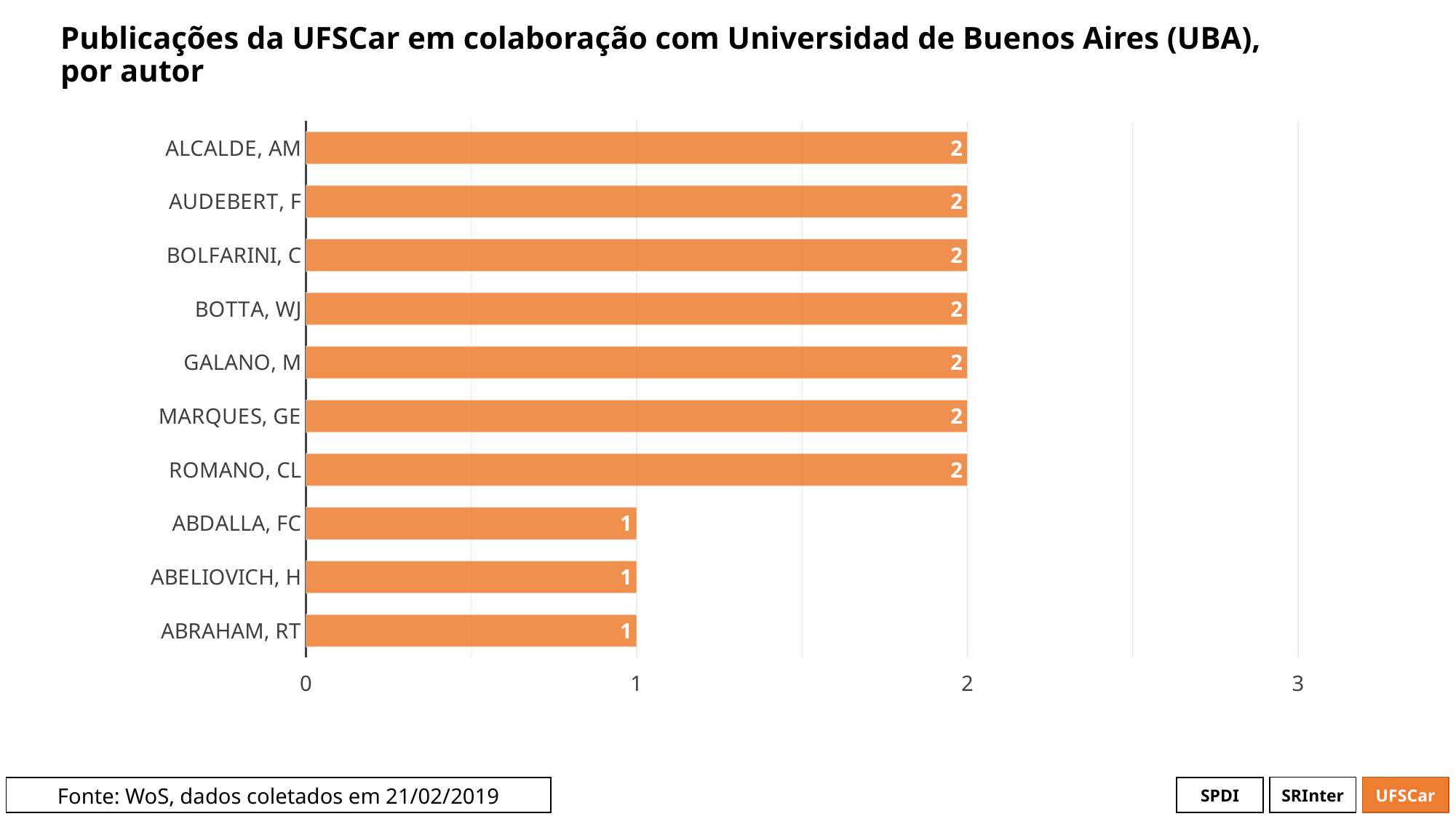
What is the data source stated at the bottom of the slide? WoS, dados coletados em 21/02/2019 How many authors have a value of 2? 7 What is the difference between the values for GALANO, M and ABELIOVICH, H? 1 What kind of chart is shown on the slide? bar chart Which is larger, the value for BOTTA, WJ or the value for ABDALLA, FC? BOTTA, WJ What is the value for ABDALLA, FC? 1 How many authors are listed in the chart? 10 What is the value for ABRAHAM, RT? 1 What is the title of the chart? Publicações da UFSCar em colaboração com Universidad de Buenos Aires (UBA), por autor What is the value for ROMANO, CL? 2 What is the value for ALCALDE, AM? 2 How many authors have a value of 1? 3